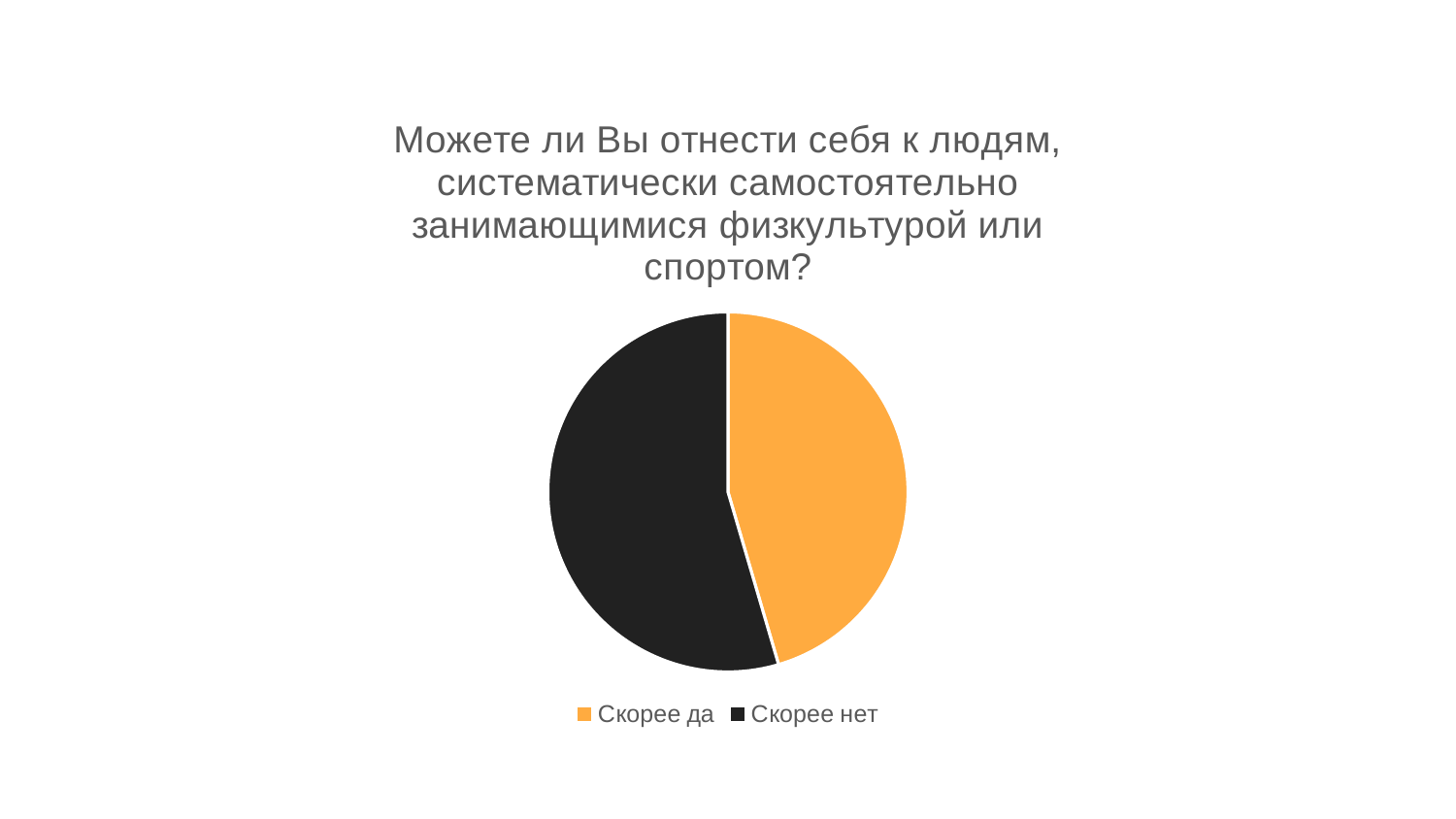
What kind of chart is shown on the slide? Pie chart What colour is the "Скорее да" slice in the pie chart? Orange Which slice of the pie chart is the largest? Скорее нет What is the title of the pie chart? Можете ли Вы отнести себя к людям, систематически самостоятельно занимающимися физкультурой или спортом? How many slices does the pie chart have? 2 Which slice is larger, "Скорее да" or "Скорее нет"? Скорее нет How many entries does the legend of the pie chart list? 2 Which slice of the pie chart is the smallest? Скорее да